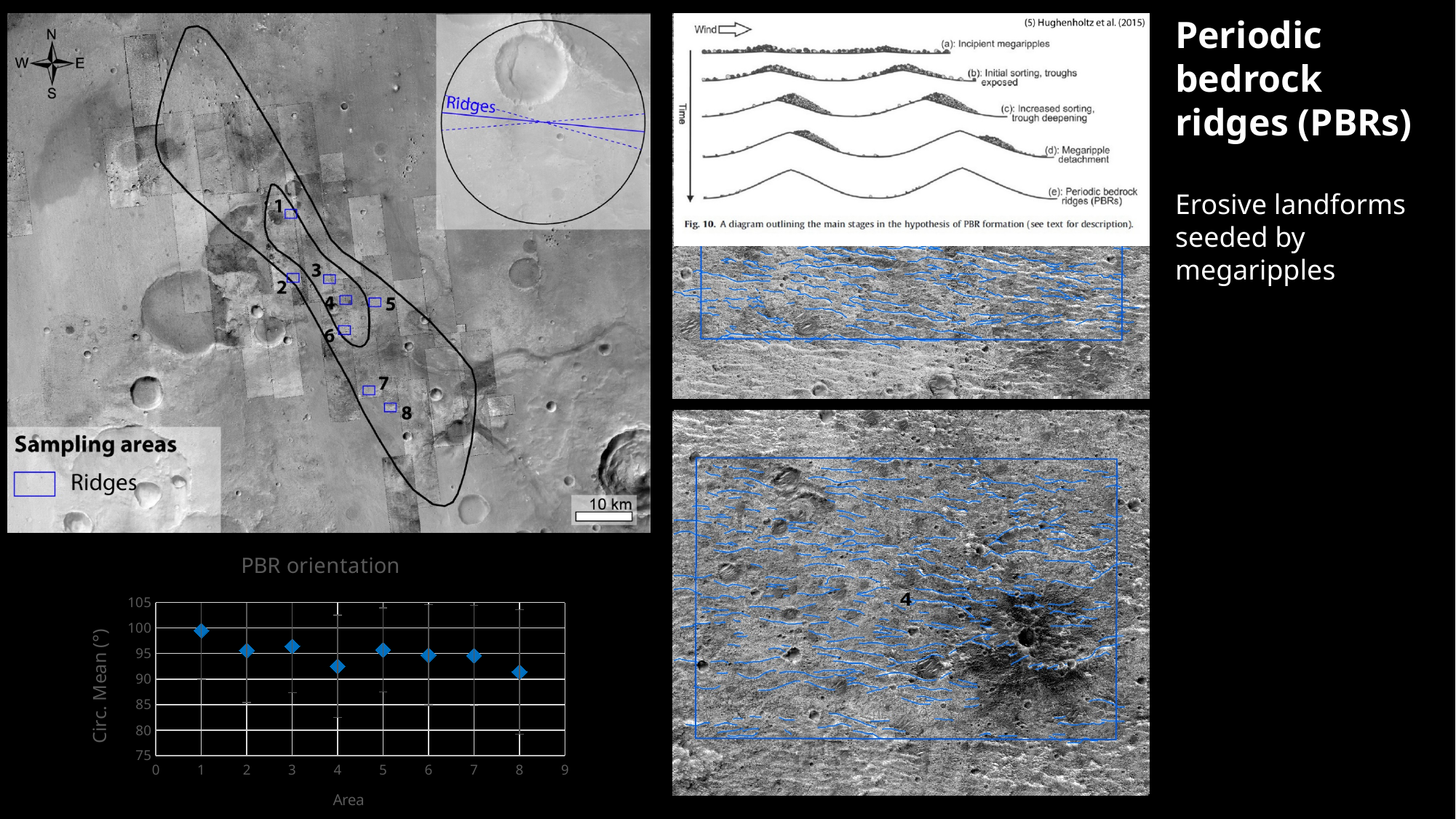
In the "PBR orientation" chart, which has the larger circular mean, Area 1 or Area 4? Area 1 In the "PBR orientation" chart, which area has the highest circular mean? Area 1 What is the label of the y axis in the "PBR orientation" chart? Circ. Mean (°) In the "PBR orientation" chart, is the value for Area 1 greater or less than 95? greater How many data points are plotted in the "PBR orientation" chart? 8 In the "PBR orientation" chart, is the value for Area 2 greater or less than 90? greater In the "PBR orientation" chart, is the value for Area 4 greater or less than 95? less In the "PBR orientation" chart, do the values generally rise or fall as the area number increases? fall What is the label of the x axis in the "PBR orientation" chart? Area What kind of chart is the "PBR orientation" chart? scatter plot In the "PBR orientation" chart, which area has the lowest circular mean? Area 8